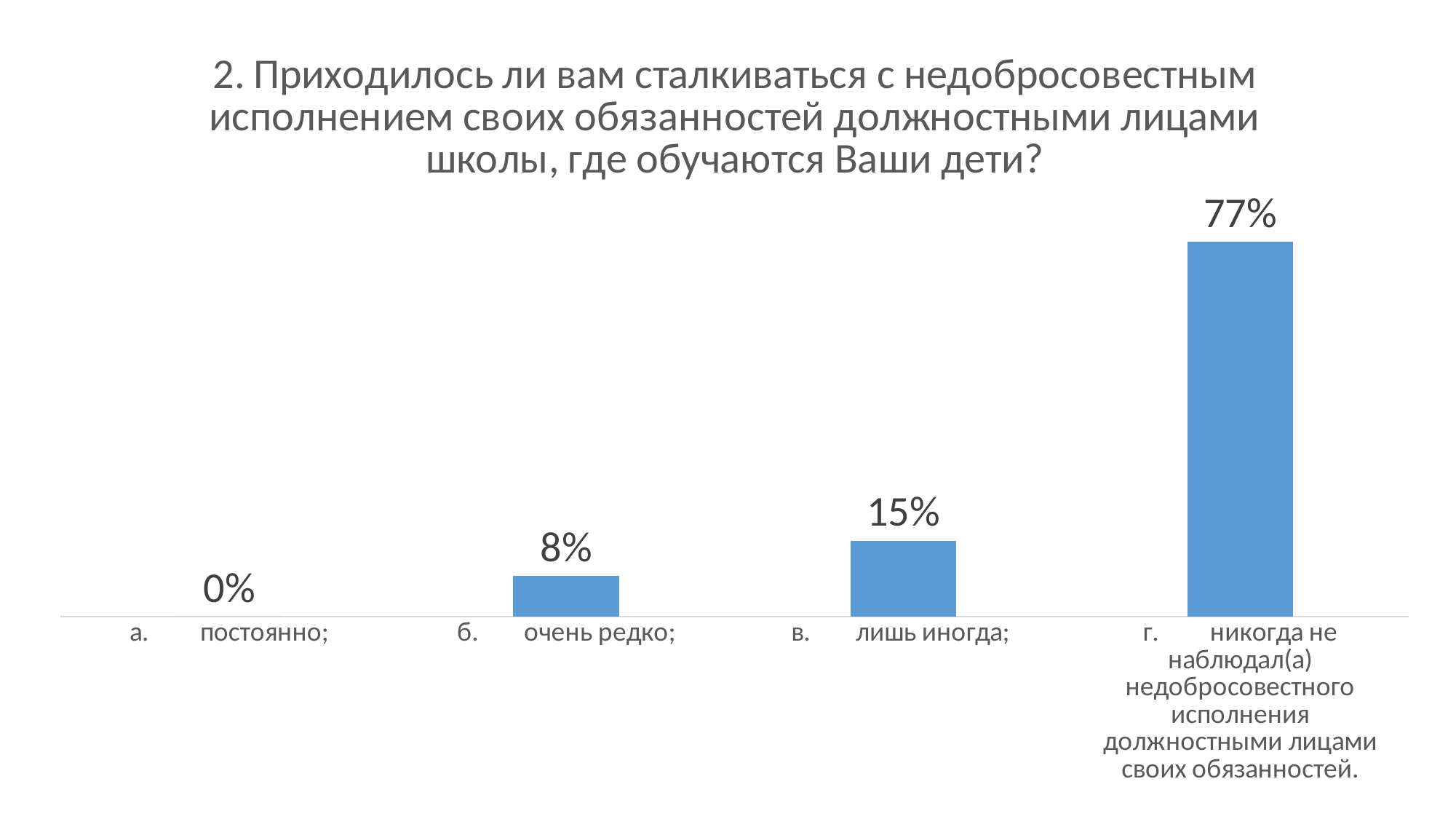
What is the value for "лишь иногда"? 15% What is the difference between the highest and lowest values on the chart? 77% Which category has the highest value? г. никогда не наблюдал(а) недобросовестного исполнения должностными лицами своих обязанностей. Which category has the lowest value? а. постоянно; What is the value for "очень редко"? 8% Do the values rise or fall from left to right along the x axis? rise How many categories are shown on the chart? 4 What kind of chart is shown on the slide? bar chart What is the value for "постоянно"? 0% What is the difference between the values for "лишь иногда" and "очень редко"? 7% What is the value for "никогда не наблюдал(а) недобросовестного исполнения должностными лицами своих обязанностей"? 77% Which is larger, the value for "очень редко" or the value for "лишь иногда"? лишь иногда